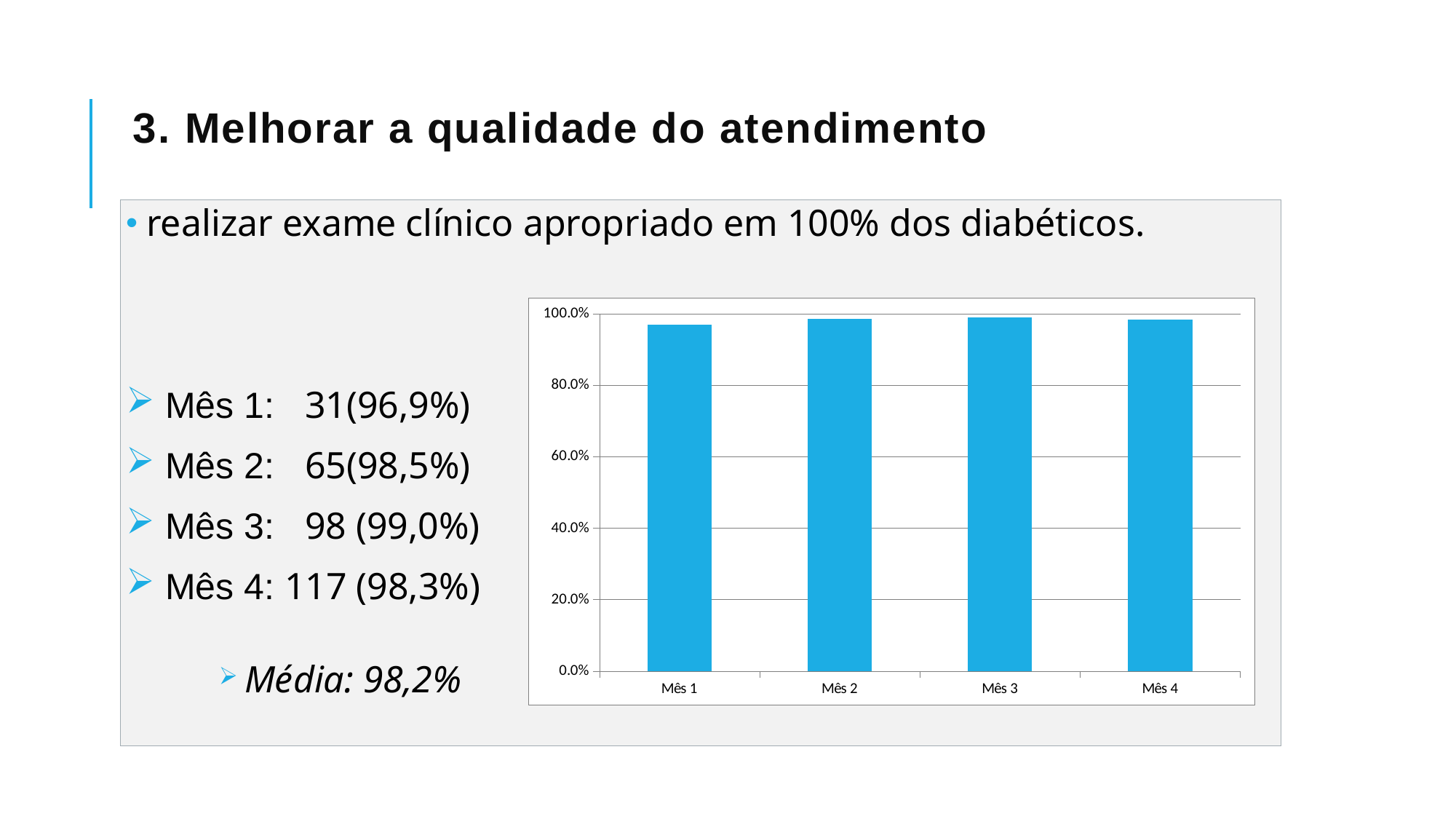
According to the slide, what is the percentage for Mês 1? 96,9% What is the average (Média) stated on the slide? 98,2% According to the slide, what is the percentage for Mês 3? 99,0% What kind of chart is shown on the slide? bar chart What is the highest value shown on the chart's vertical axis? 100.0% What is the difference between the percentages for Mês 3 and Mês 1? 2,1% Is the value for Mês 1 greater or less than 80.0%? greater Which month has the highest percentage in the chart? Mês 3 How many months (categories) are plotted in the chart? 4 Which month has the lowest percentage in the chart? Mês 1 According to the slide, what is the percentage for Mês 4? 98,3% Is the value for Mês 4 greater or less than 60.0%? greater